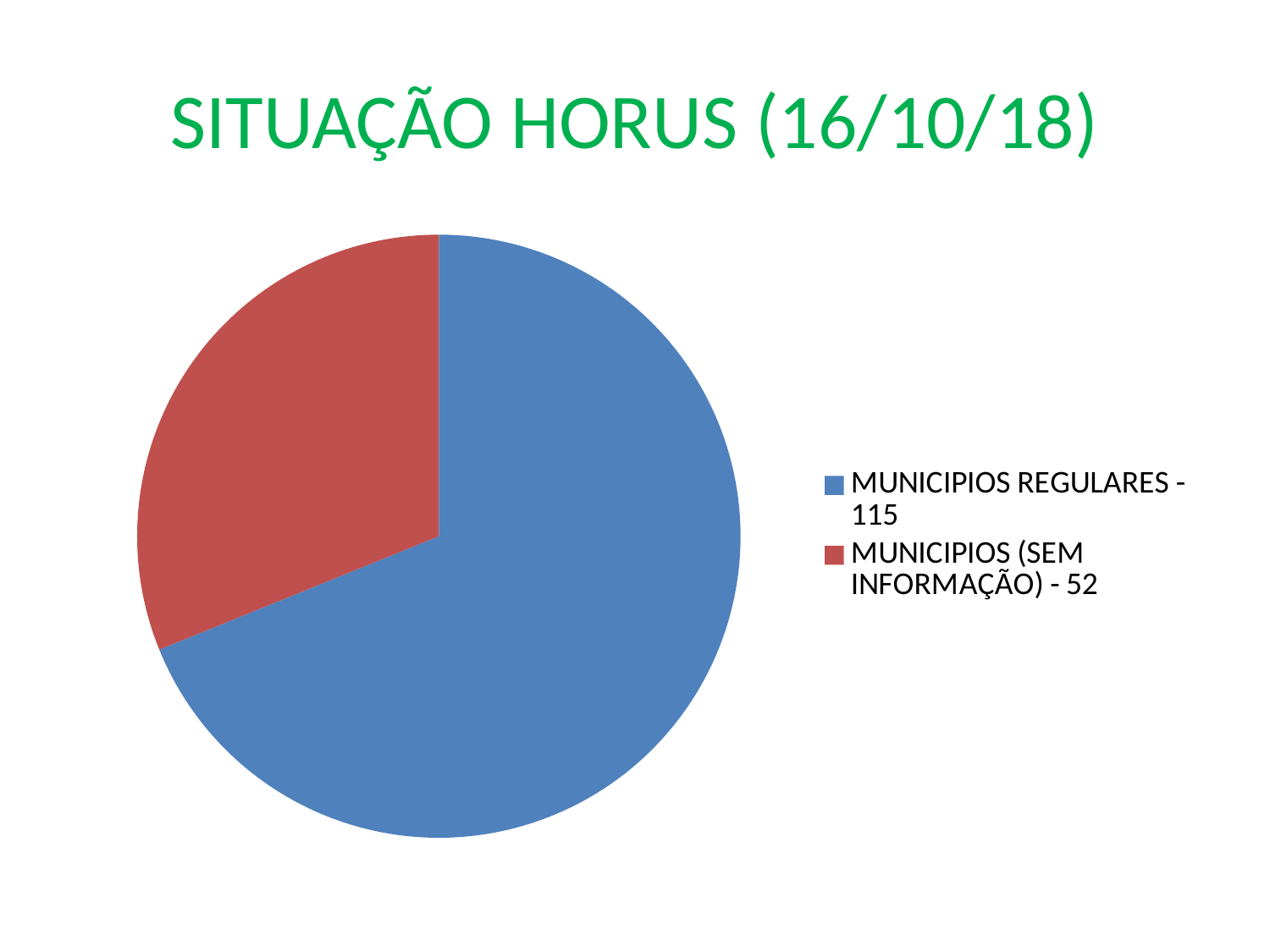
What is the value for MUNICIPIOS (SEM INFORMAÇÃO)? 52 What is the difference between MUNICIPIOS REGULARES and MUNICIPIOS (SEM INFORMAÇÃO)? 63 How many slices does the pie chart have? 2 Which category has the smallest slice of the pie? MUNICIPIOS (SEM INFORMAÇÃO) What is the title of the chart on the slide? SITUAÇÃO HORUS (16/10/18) How many entries does the legend list? 2 Which is larger, MUNICIPIOS REGULARES or MUNICIPIOS (SEM INFORMAÇÃO)? MUNICIPIOS REGULARES What is the total of the two categories in the pie chart? 167 What is the value for MUNICIPIOS REGULARES? 115 Which category has the largest slice of the pie? MUNICIPIOS REGULARES Which colour represents MUNICIPIOS (SEM INFORMAÇÃO) in the pie chart? Red What type of chart is shown on the slide? Pie chart